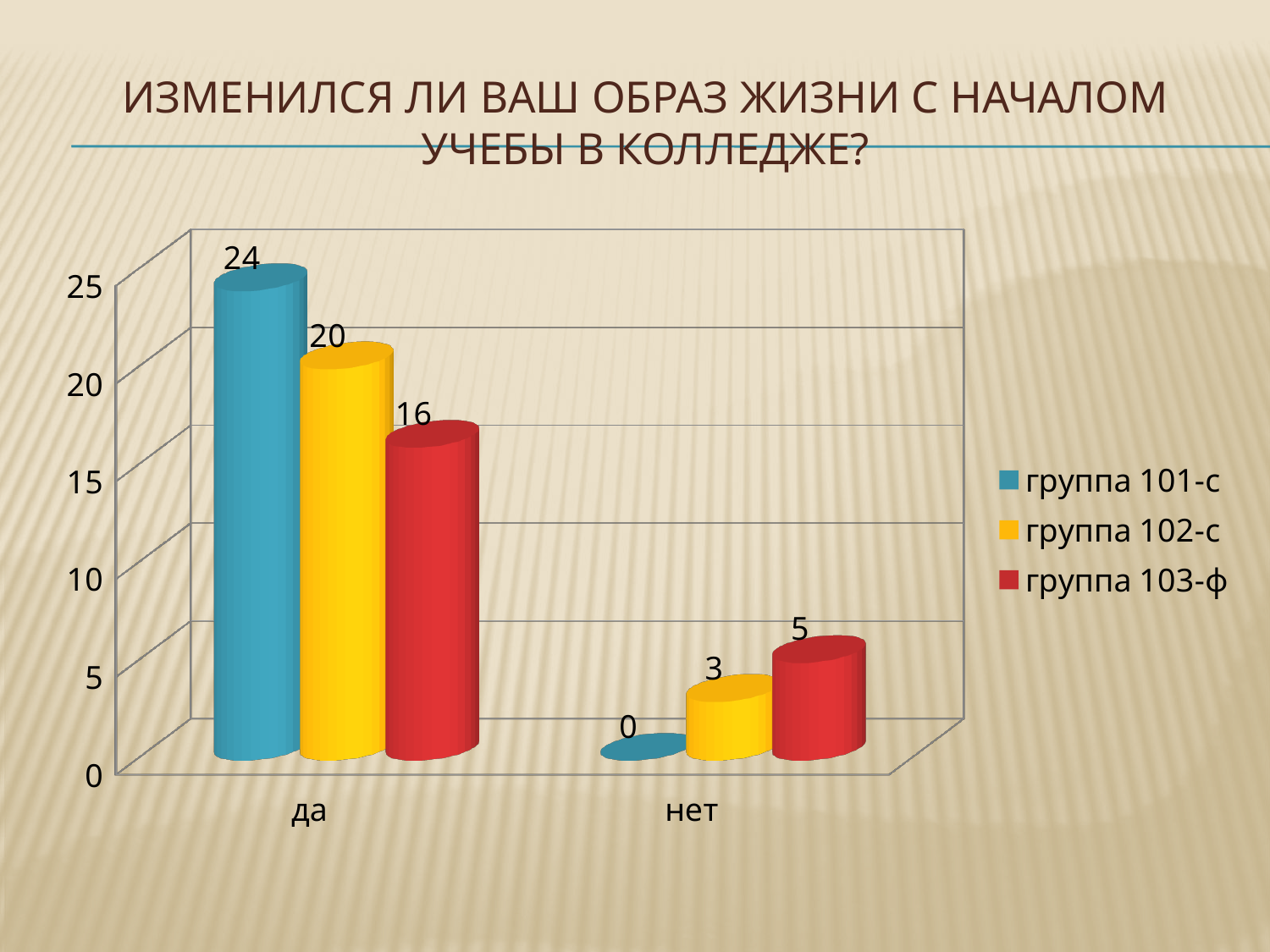
What is the value for группа 102-с in the да category? 20 What kind of chart is shown on the slide? bar chart What colour represents группа 102-с in the chart? yellow How many series does the legend list? 3 What is the value for группа 101-с in the да category? 24 Which is larger in the нет category: группа 102-с or группа 103-ф? группа 103-ф Is the value for группа 103-ф in the да category greater or less than 15? greater Which group has the lowest value in the нет category? группа 101-с What is the difference between группа 101-с and группа 103-ф in the да category? 8 Which group has the highest value in the да category? группа 101-с What is the value for группа 103-ф in the нет category? 5 How many categories are shown on the x axis? 2